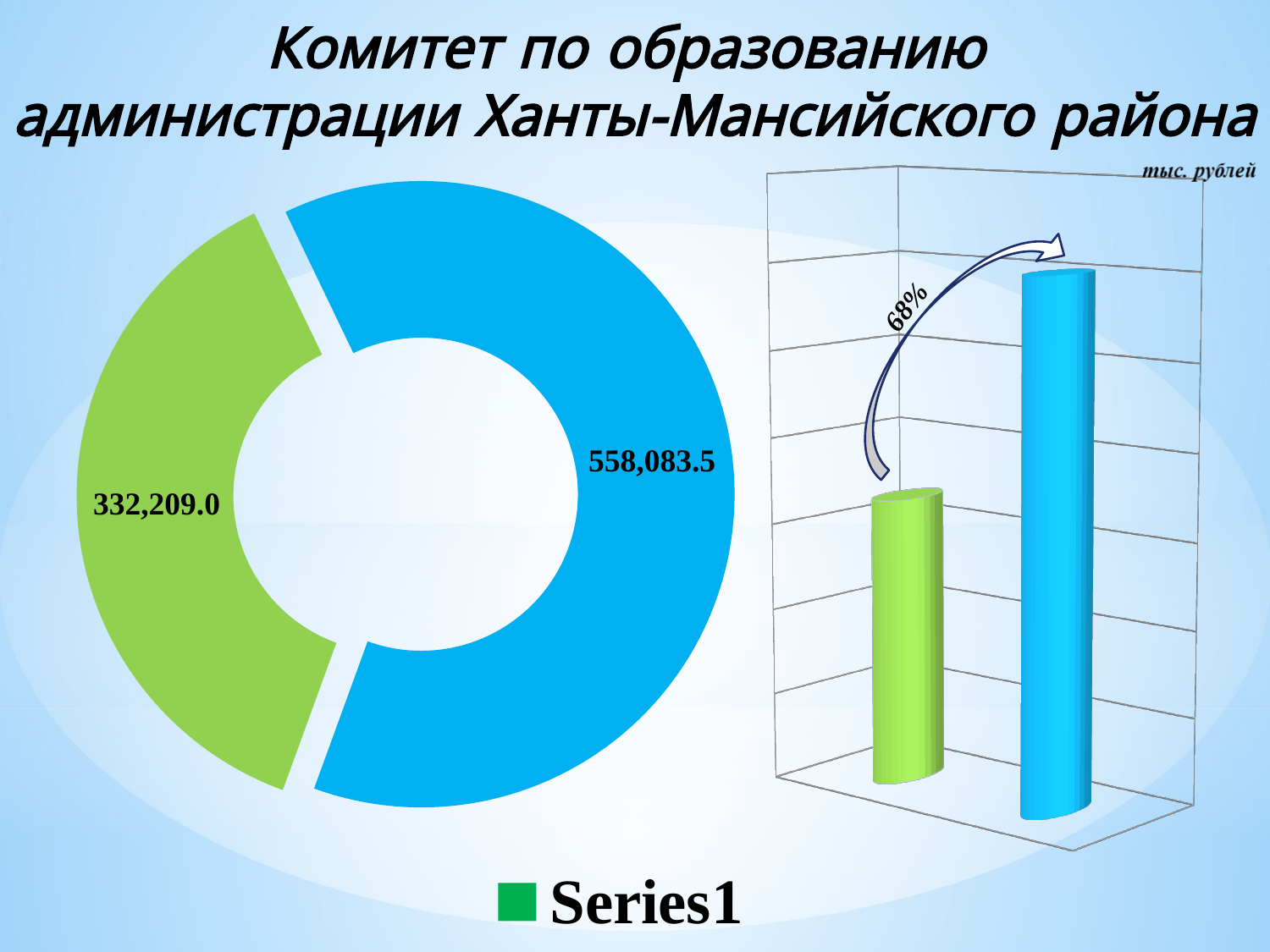
In the doughnut chart on the left, which slice has the smaller value? the green slice What kind of chart is shown on the left side of the slide? doughnut chart In the doughnut chart on the left, what value is shown for the green slice? 332,209.0 How many bars does the bar chart on the right have? 2 What percentage is written next to the arrow in the bar chart on the right? 68% In the bar chart on the right, which bar is taller, the green or the blue one? the blue bar How many slices does the doughnut chart on the left have? 2 What kind of chart is shown on the right side of the slide? bar chart In the doughnut chart on the left, what is the total of the two slice values? 890,292.5 In the doughnut chart on the left, what value is shown for the blue slice? 558,083.5 In the doughnut chart on the left, what is the difference between the blue slice value and the green slice value? 225,874.5 In the doughnut chart on the left, which slice has the larger value, the green or the blue one? the blue slice